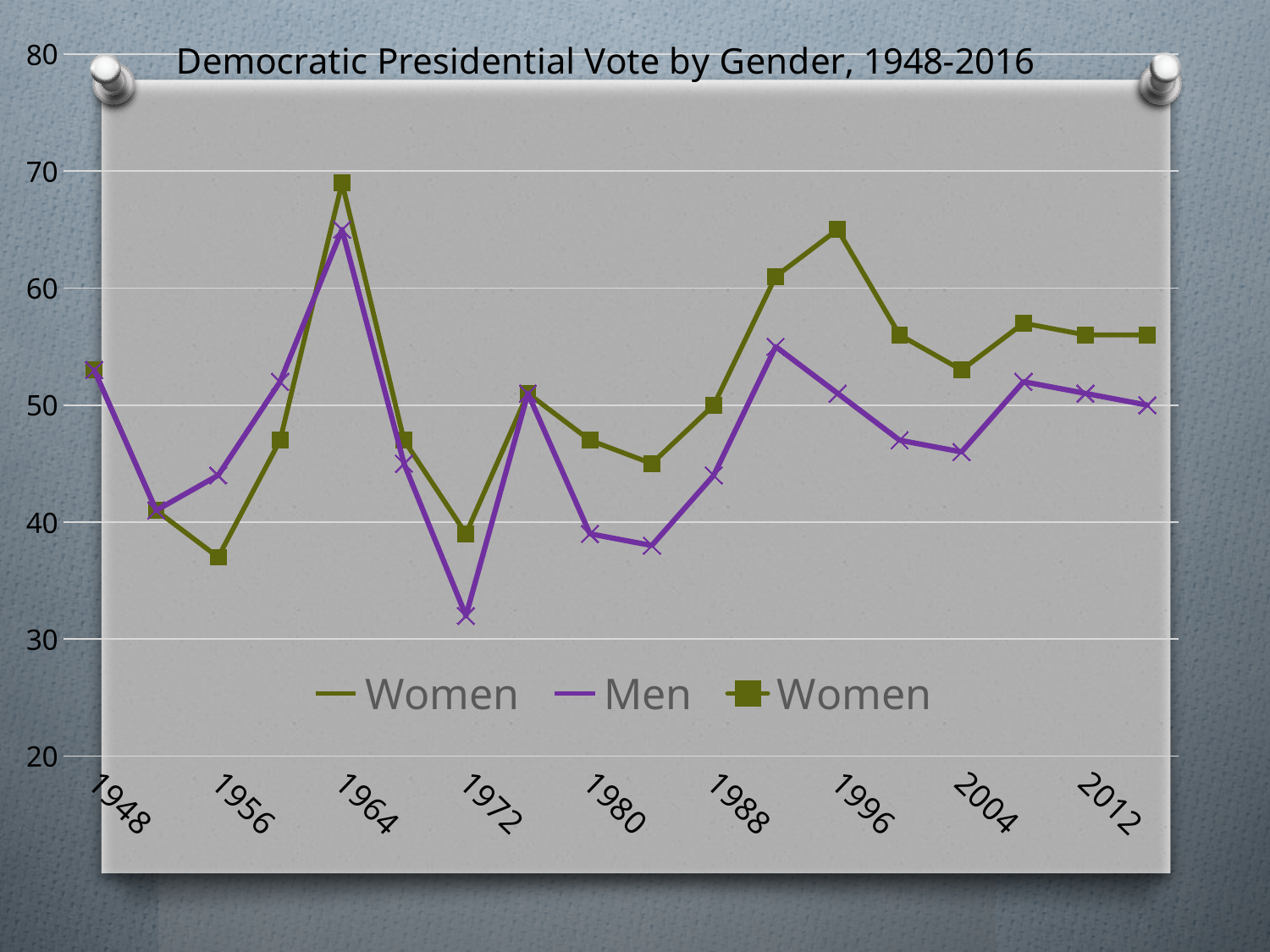
In which year does the Women series reach its lowest value? 1956 In which year does the Men series reach its lowest value? 1972 In which year does the Women series reach its highest value? 1964 Is the value for Women in 1996 greater or less than 60? greater How many year labels are shown along the x axis? 9 Is the value for Women in 1964 greater or less than 60? greater What is the title of the chart? Democratic Presidential Vote by Gender, 1948-2016 What kind of chart is shown on the slide? line chart In 1996, which series has the larger value, Women or Men? Women How many entries does the chart legend list? 3 Does the Men series rise or fall from 2008 to 2016? fall Is the value for Men in 1972 greater or less than 40? less